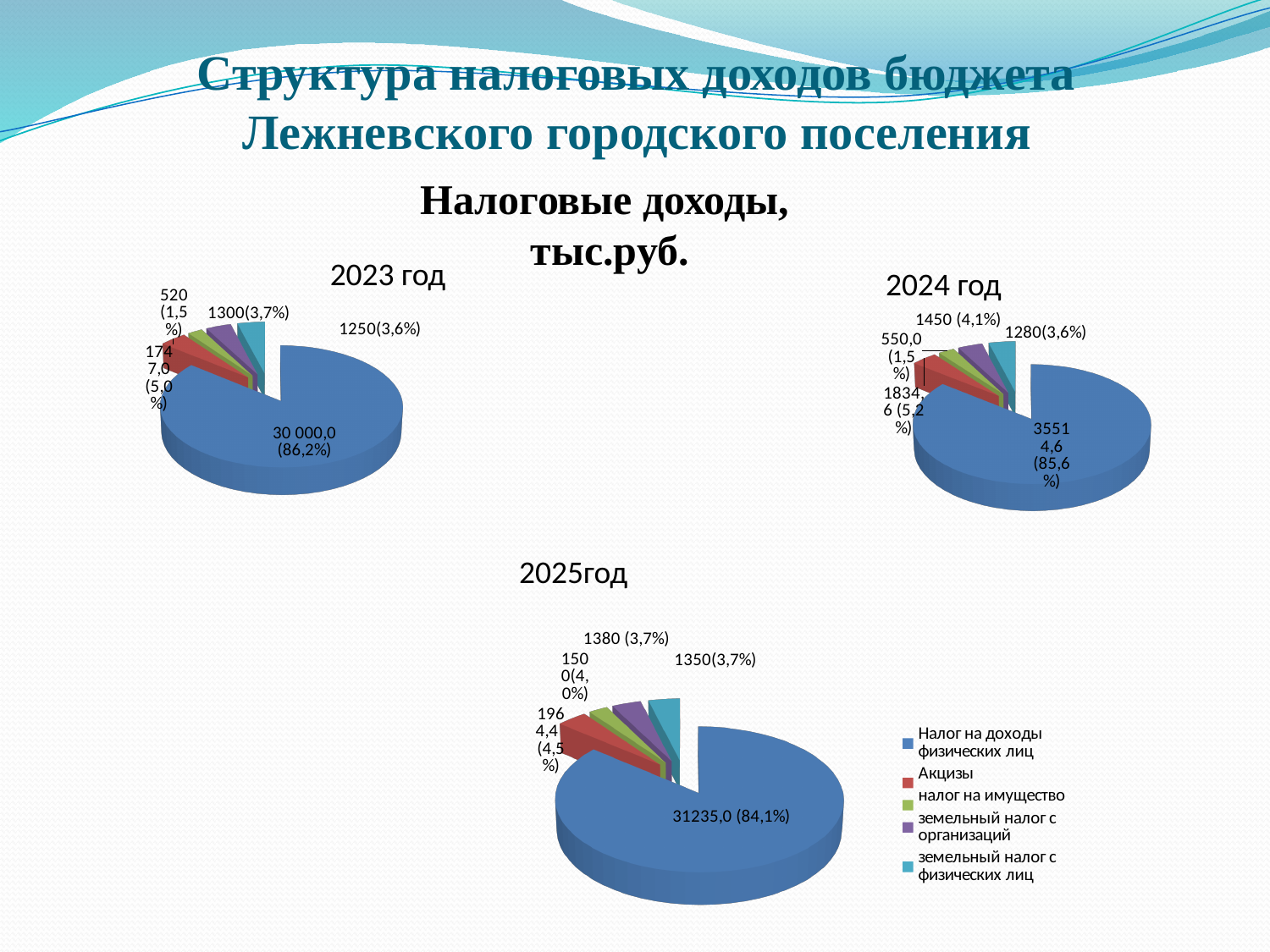
What is the title shown above the three pie charts? Налоговые доходы, тыс.руб. In the 2025год chart, what value is shown for Налог на доходы физических лиц? 31235,0 In the 2024 год chart, which category has the largest share? Налог на доходы физических лиц What type of chart is used for the 2023 год chart? pie chart In the 2024 год chart, what is the smallest share shown on a data label? 1,5% How many series does the legend on the slide list? 5 In the 2023 год chart, what value is shown for the largest slice? 30 000,0 How many slices does the 2025год pie chart have? 5 In the 2025год chart, what share of the pie does the largest slice have? 84,1% In the 2024 год chart, what share is shown for the largest slice? 85,6% Which is larger: the share of the largest slice in the 2023 год chart or in the 2025год chart? 2023 год In the 2023 год chart, what share of the pie does the largest slice (Налог на доходы физических лиц) have? 86,2%